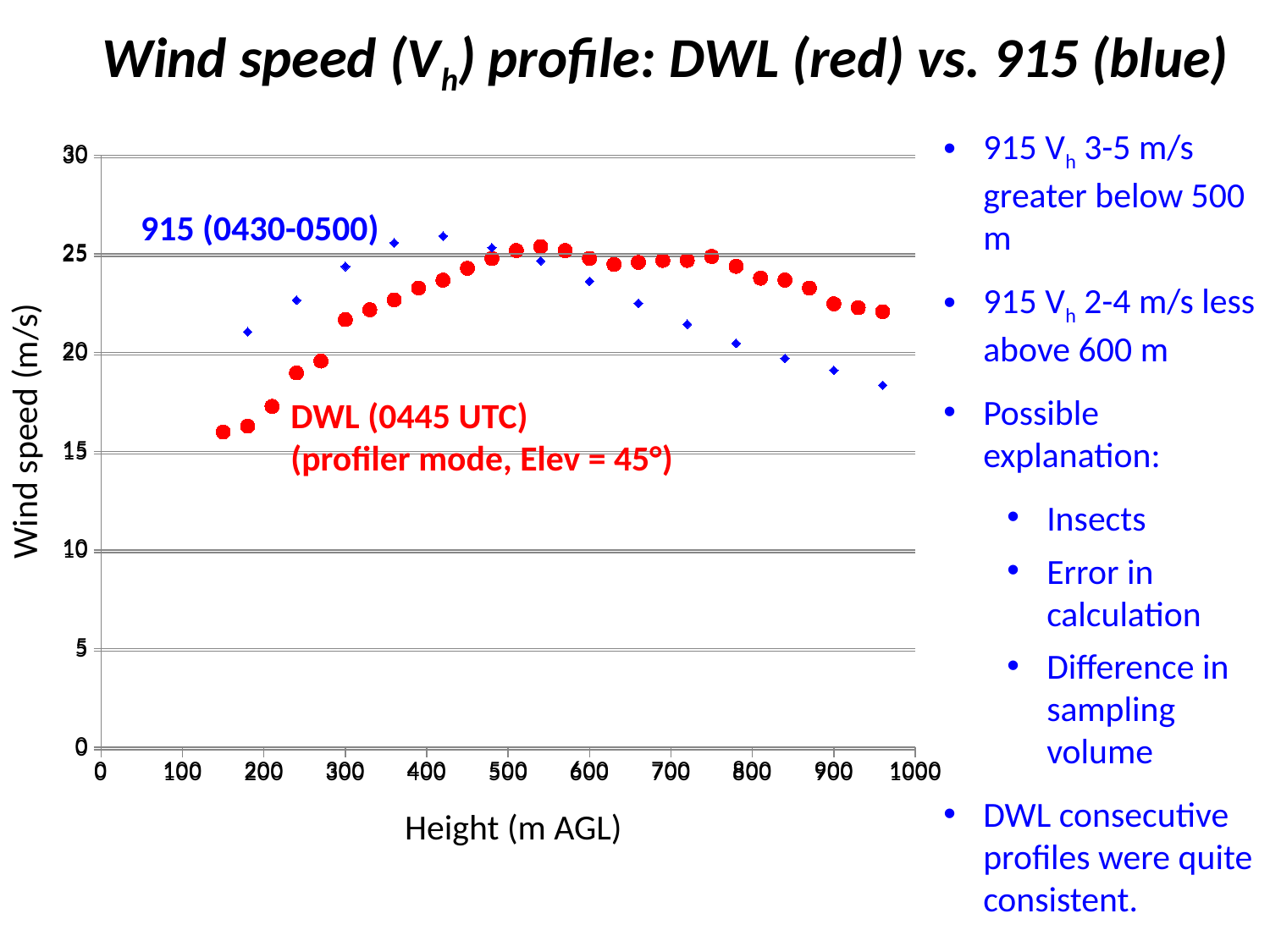
What is the label of the x axis of the chart? Height (m AGL) What kind of chart is shown on the slide? Scatter chart Is the DWL (0445 UTC) wind speed at 960 m AGL greater or less than 20 m/s? greater Is the DWL (0445 UTC) wind speed at 150 m AGL greater or less than 20 m/s? less How many data series are plotted on the chart? 2 Does the DWL (0445 UTC) wind speed rise or fall as height increases from 150 m to 500 m AGL? rise Does the 915 (0430-0500) wind speed rise or fall as height increases from 500 m to 1000 m AGL? fall Is the 915 (0430-0500) wind speed at 960 m AGL greater or less than 20 m/s? less At 300 m AGL, which series shows the higher wind speed, 915 (0430-0500) or DWL (0445 UTC)? 915 (0430-0500) What is the label of the y axis of the chart? Wind speed (m/s) At 900 m AGL, which series shows the higher wind speed, 915 (0430-0500) or DWL (0445 UTC)? DWL (0445 UTC)